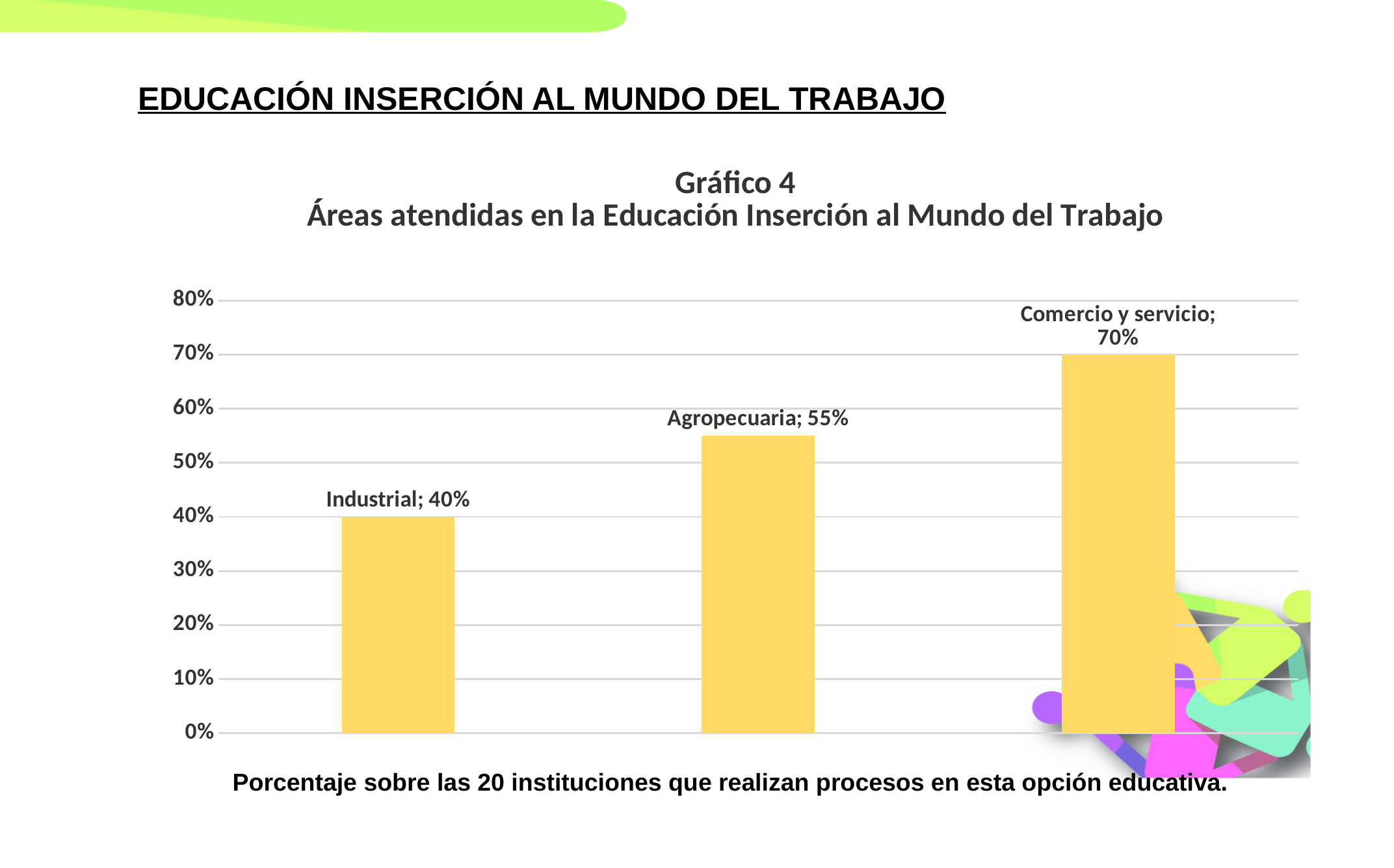
What is the value for Agropecuaria? 55% What is the difference between the values for Agropecuaria and Industrial? 15% Which category has the highest value? Comercio y servicio Is the value for Agropecuaria greater or less than 50%? greater Which category has the lowest value? Industrial What is the title of the chart? Gráfico 4 Áreas atendidas en la Educación Inserción al Mundo del Trabajo Which is larger, the value for Agropecuaria or the value for Industrial? Agropecuaria What is the difference between the values for Comercio y servicio and Industrial? 30% What is the value for Comercio y servicio? 70% What is the value for Industrial? 40% How many categories are shown in the chart? 3 What kind of chart is shown on the slide? bar chart